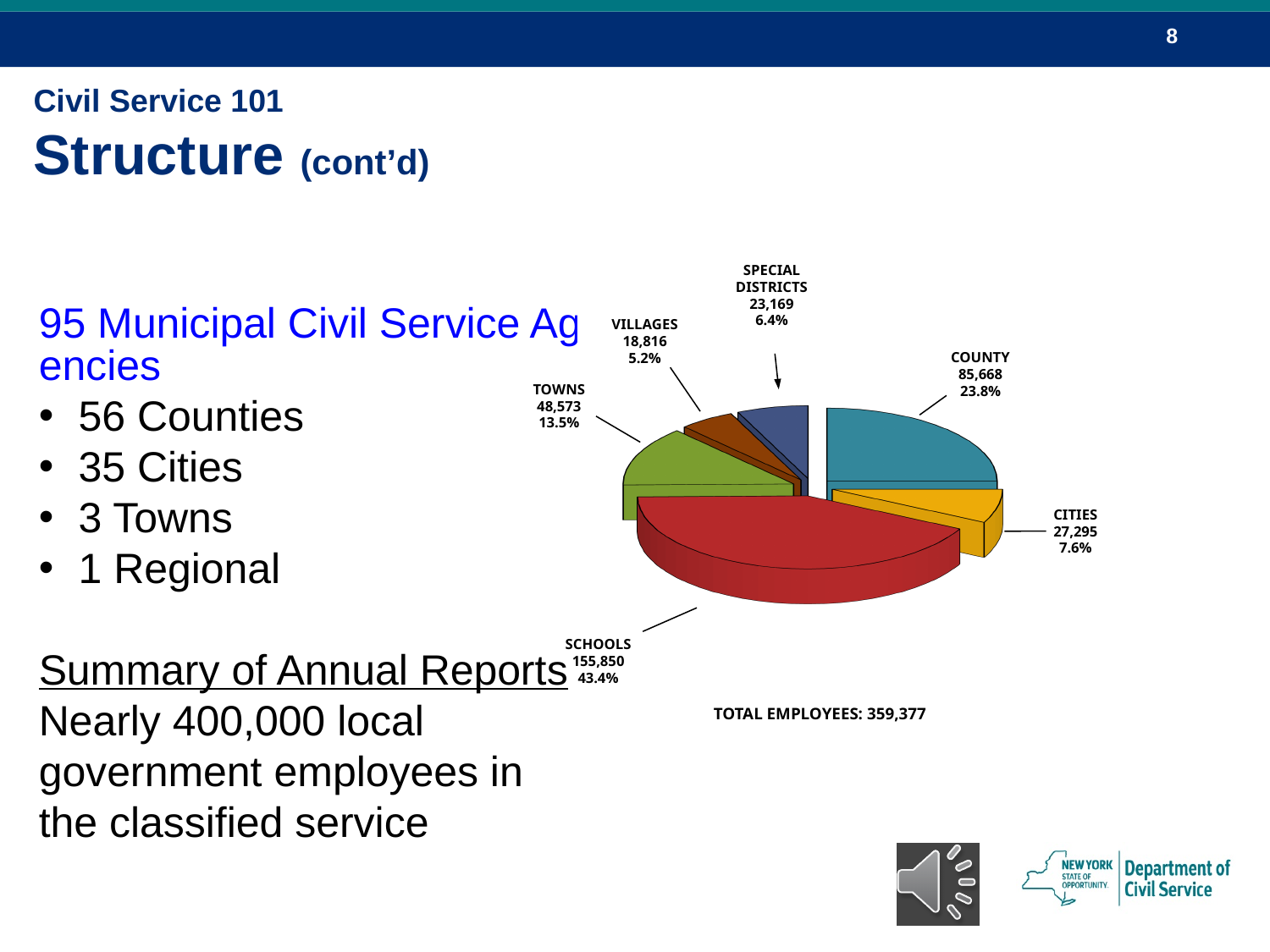
Which category has the largest slice of the pie? SCHOOLS What percentage share does the COUNTY slice have? 23.8% What is the difference in employees between COUNTY and CITIES? 58,373 Which category has the smallest slice of the pie? VILLAGES How many employees are in the SCHOOLS slice? 155,850 How many employees are in the VILLAGES slice? 18,816 What is the total number of employees shown below the pie chart? 359,377 What kind of chart is shown on the slide? pie chart Which has more employees, TOWNS or SPECIAL DISTRICTS? TOWNS What colour is the SCHOOLS slice? red What percentage share does the CITIES slice have? 7.6% How many categories does the pie chart show? 6